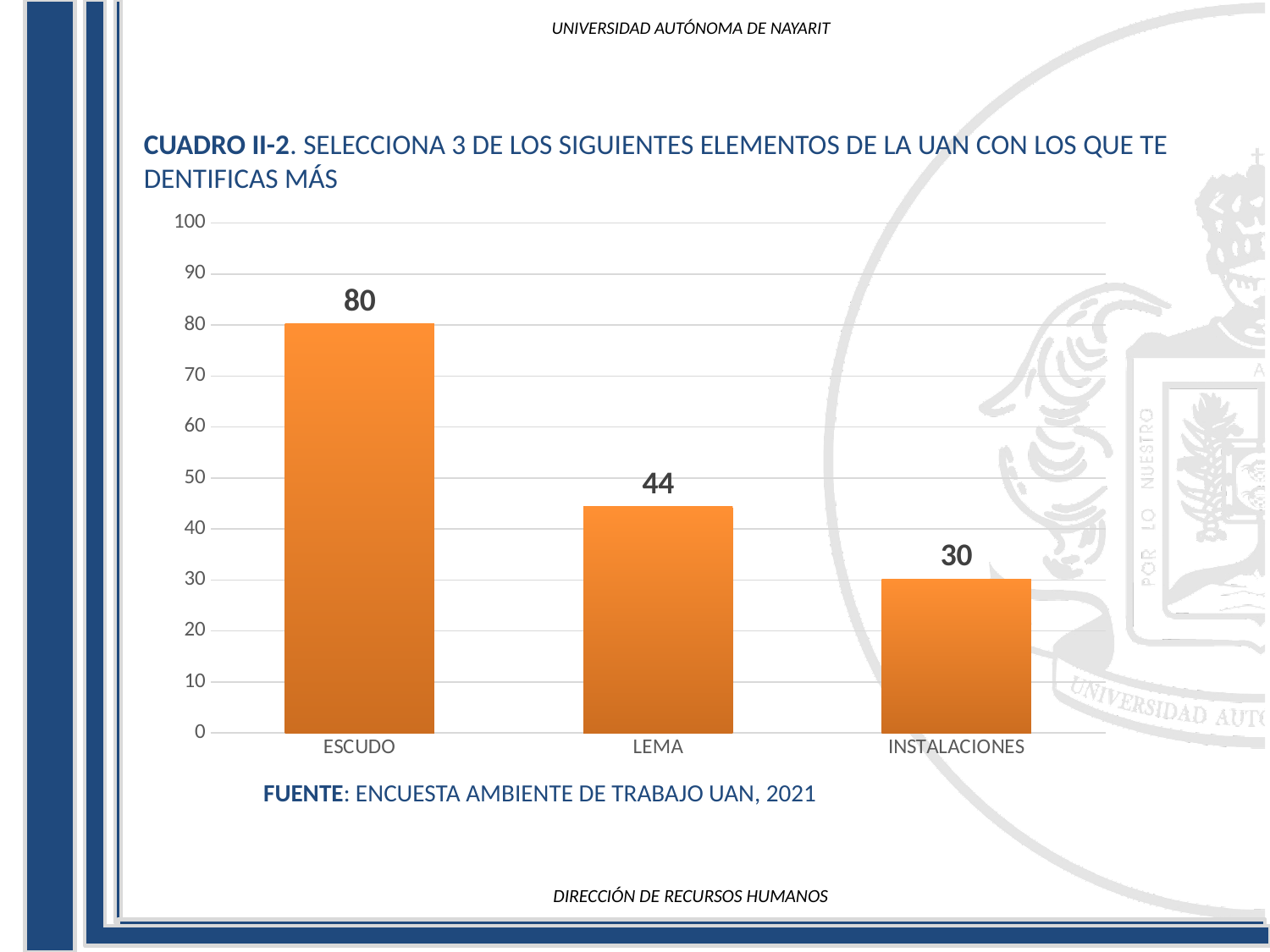
What is the value for INSTALACIONES? 30 How many categories are shown on the x axis? 3 What kind of chart is shown on the slide? bar chart Is the value for ESCUDO greater or less than 70? greater What is the difference between the values for LEMA and INSTALACIONES? 14 Which category has the lowest value? INSTALACIONES Which is larger, the value for LEMA or the value for INSTALACIONES? LEMA What is the value for ESCUDO? 80 Do the values rise or fall from left to right along the x axis? fall What is the value for LEMA? 44 Which category has the highest value? ESCUDO What is the difference between the values for ESCUDO and LEMA? 36